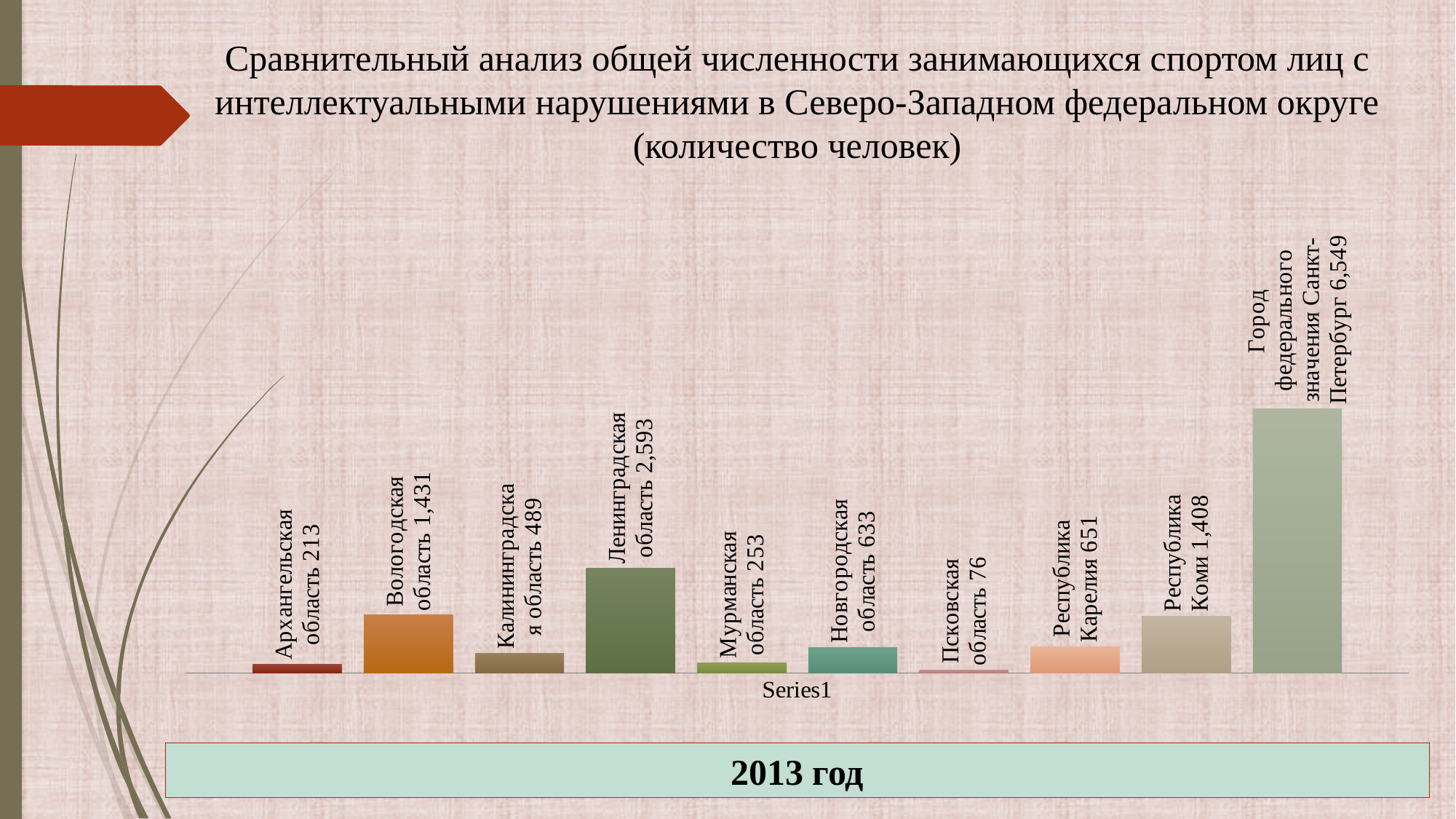
What is the value shown for Псковская область? 76 What type of chart is shown on the slide? Bar chart How many regions (bars) are shown on the chart? 10 Which region has the highest value on the chart? Город федерального значения Санкт-Петербург What year does the chart refer to, according to the label below it? 2013 год Which is larger, the value for Вологодская область or the value for Республика Коми? Вологодская область Which region has the lowest value on the chart? Псковская область Which is larger, the value for Мурманская область or the value for Калининградская область? Калининградская область What is the difference between the values for Санкт-Петербург and Ленинградская область? 3,956 What is the value shown for Республика Коми? 1,408 What is the difference between the values for Республика Карелия and Новгородская область? 18 What is the value shown for Ленинградская область? 2,593